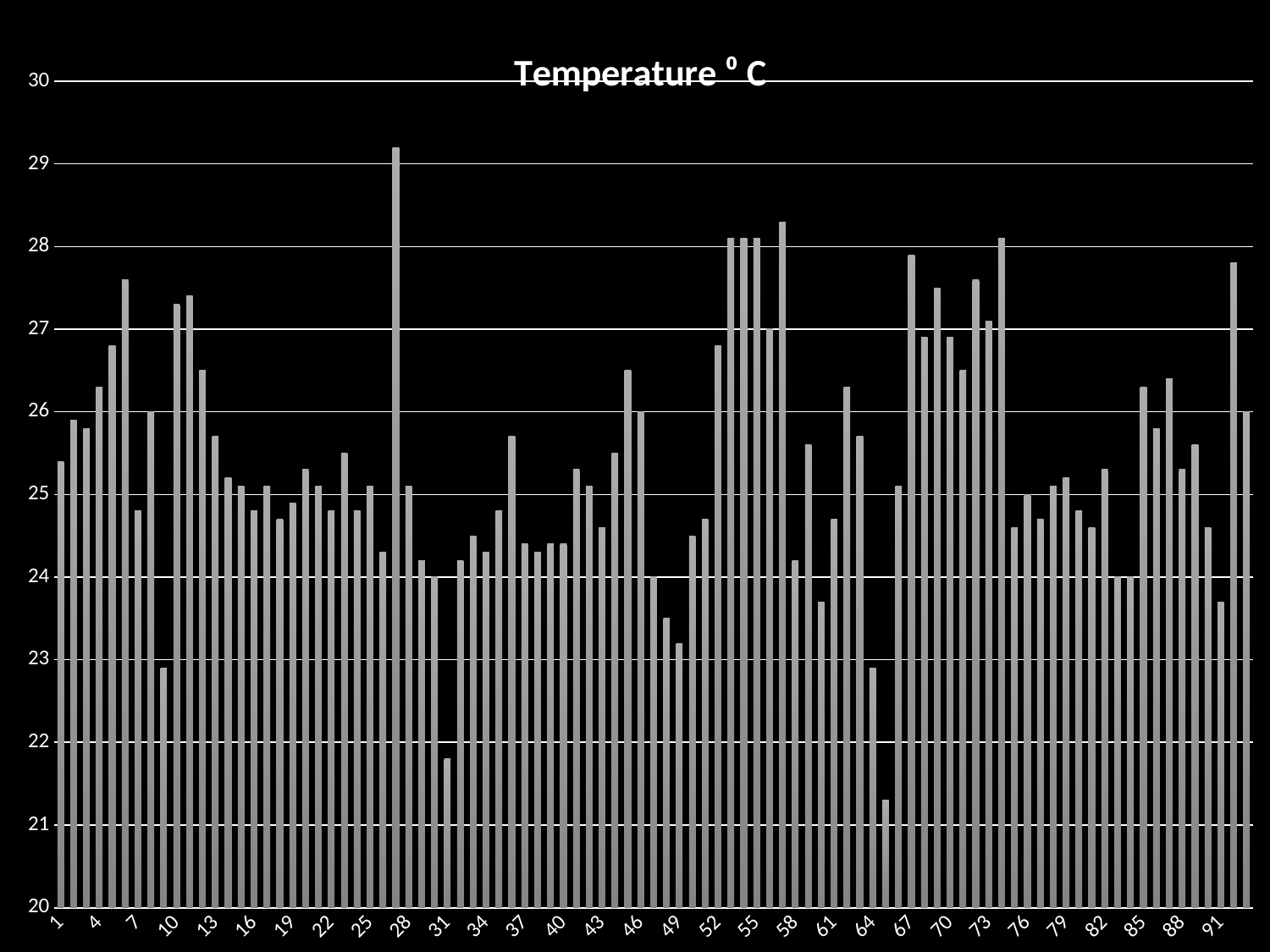
Is the value for category 7 greater or less than 25? less Is the value for category 10 greater or less than 27? greater Which category has the highest temperature? 27 Is the highest value on the chart greater or less than 29? greater What is the title of the chart? Temperature ⁰ C Which is larger, the value for category 4 or the value for category 7? category 4 What kind of chart is shown on the slide? bar chart What colour are the bars in the chart? grey